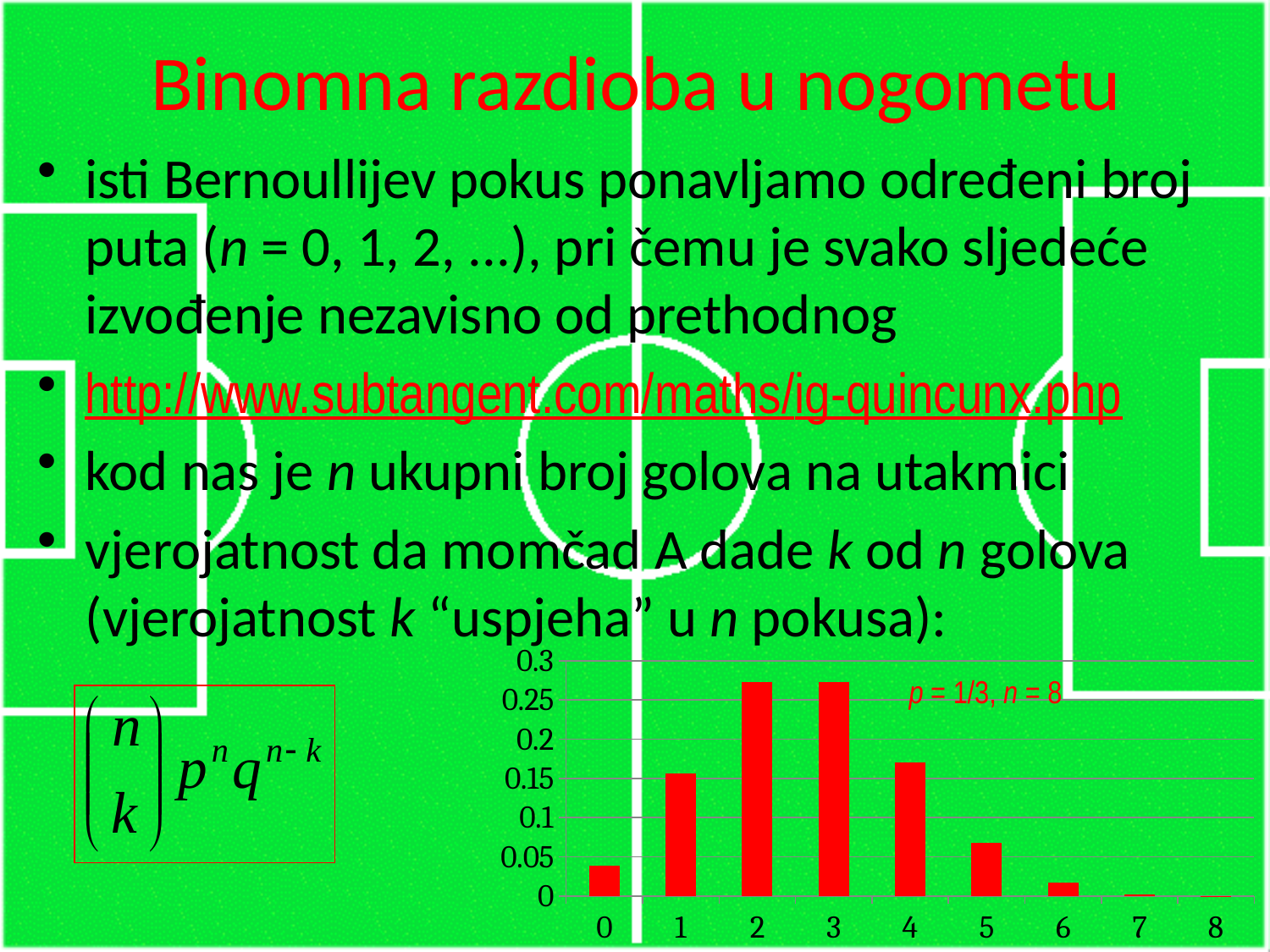
Is the value for category 2 greater or less than 0.25? greater From category 3 to category 8, do the values rise or fall? fall What parameter values are annotated on the chart? p = 1/3, n = 8 Is the value for category 4 greater or less than 0.2? less What colour are the bars in the chart? red Is the value for category 0 greater or less than 0.05? less What kind of chart is shown on the slide? bar chart How many categories are shown on the x axis of the chart? 9 Which is larger, the value for category 0 or the value for category 6? 0 Which is larger, the value for category 1 or the value for category 5? 1